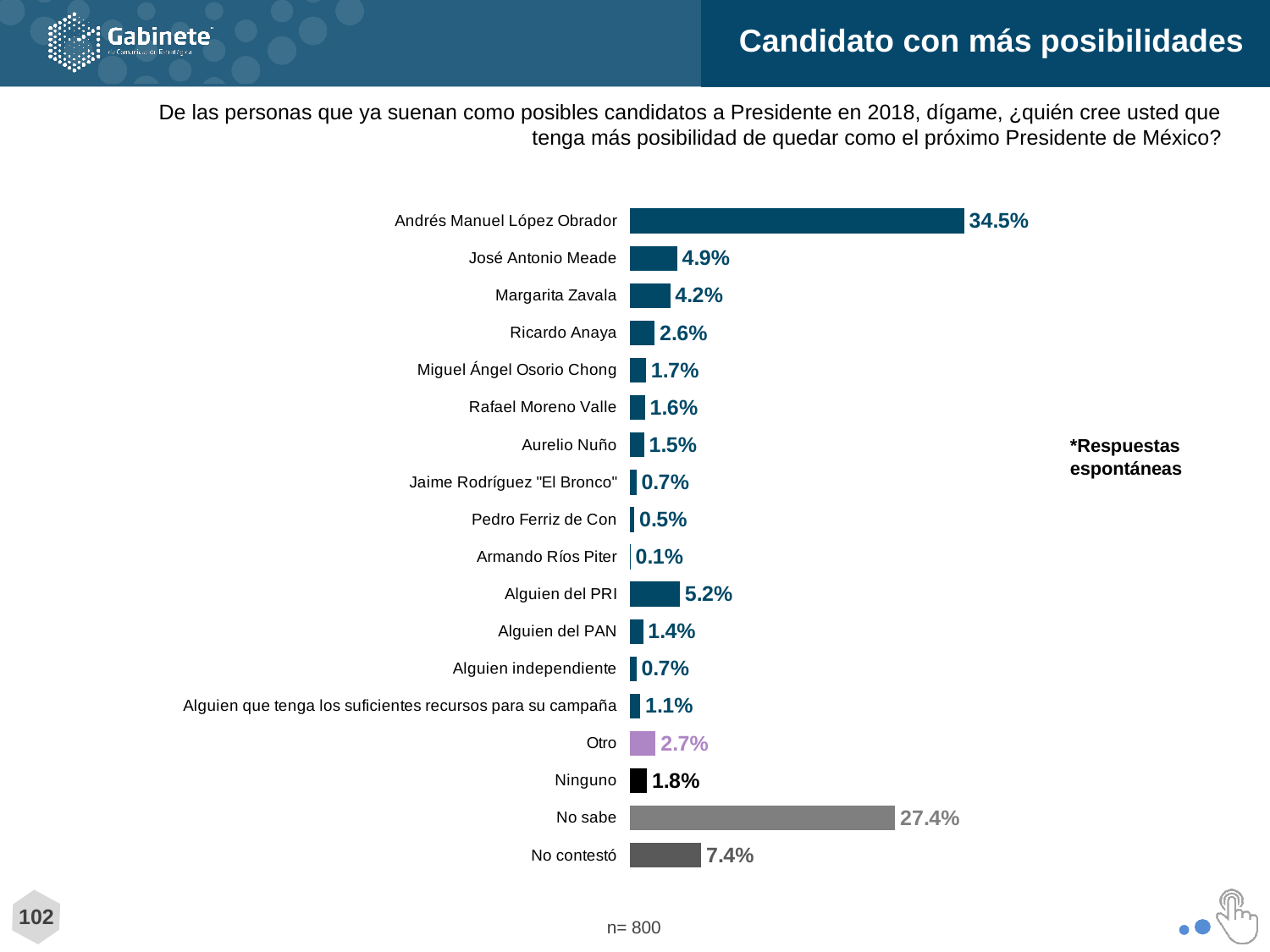
What is the value for No sabe? 27.4% What is the value for Andrés Manuel López Obrador? 34.5% How many categories are shown in the chart? 18 What is the difference between the values for Andrés Manuel López Obrador and No sabe? 7.1% What type of chart is shown on the slide? bar chart What is the difference between the values for José Antonio Meade and Margarita Zavala? 0.7% What is the title of the slide containing the chart? Candidato con más posibilidades Which is larger, the value for Alguien del PRI or the value for José Antonio Meade? Alguien del PRI What is the value for Margarita Zavala? 4.2% Which category has the highest value? Andrés Manuel López Obrador Which category has the lowest value? Armando Ríos Piter What is the value for Alguien del PRI? 5.2%